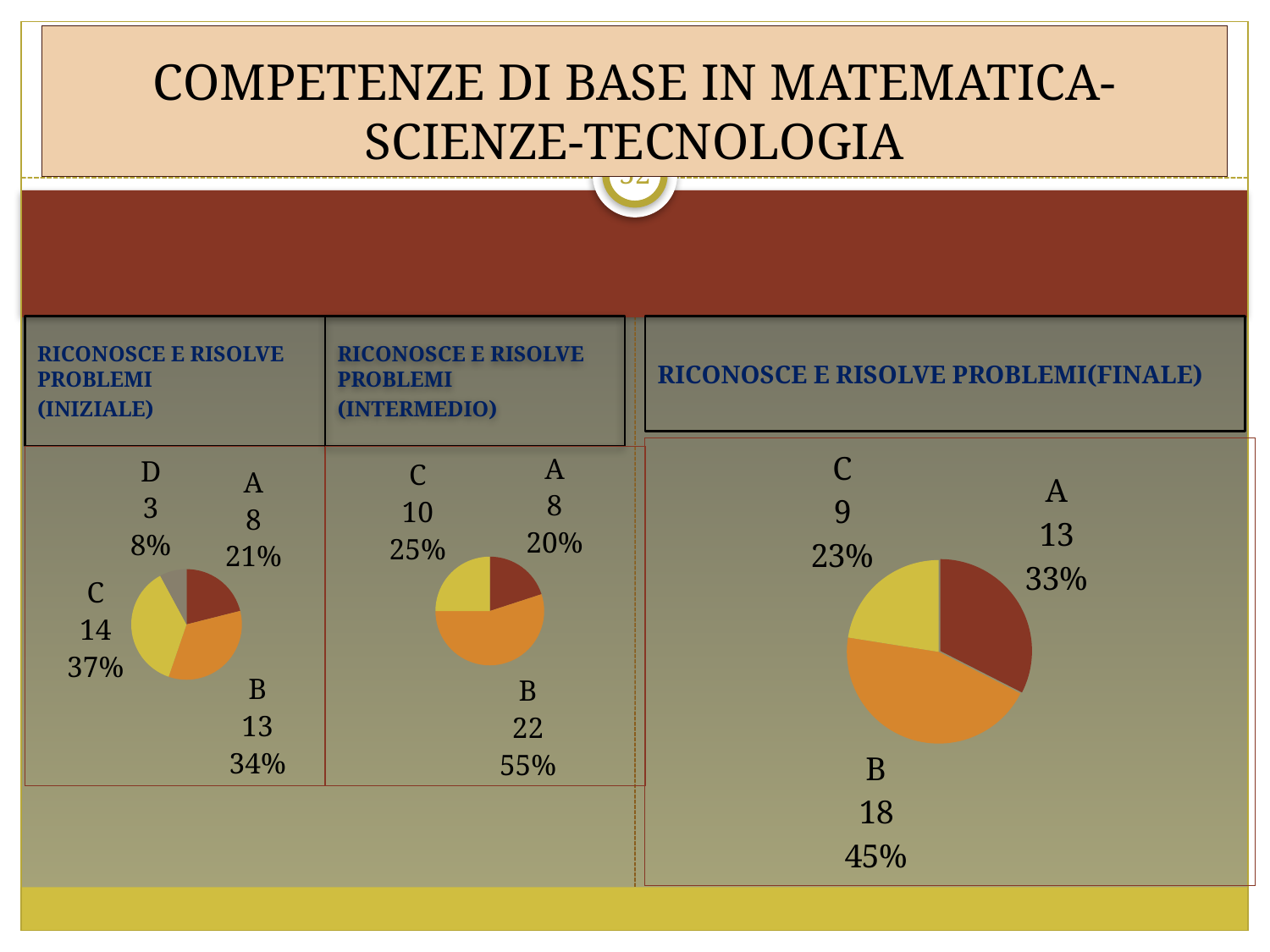
In the RICONOSCE E RISOLVE PROBLEMI (FINALE) chart, which is larger, the value for A or the value for C? A In the RICONOSCE E RISOLVE PROBLEMI (INIZIALE) chart, what percentage share does category D have? 8% What type of chart is used for RICONOSCE E RISOLVE PROBLEMI (FINALE)? Pie chart In the RICONOSCE E RISOLVE PROBLEMI (INTERMEDIO) chart, what is the difference between the values for B and C? 12 How many categories are shown in the RICONOSCE E RISOLVE PROBLEMI (FINALE) chart? 3 How many categories are shown in the RICONOSCE E RISOLVE PROBLEMI (INIZIALE) chart? 4 In the RICONOSCE E RISOLVE PROBLEMI (INIZIALE) chart, what is the value for category C? 14 In the RICONOSCE E RISOLVE PROBLEMI (FINALE) chart, what is the difference between the values for B and A? 5 In the RICONOSCE E RISOLVE PROBLEMI (INTERMEDIO) chart, which category has the highest value? B In the RICONOSCE E RISOLVE PROBLEMI (INTERMEDIO) chart, what is the value for category B? 22 In the RICONOSCE E RISOLVE PROBLEMI (INIZIALE) chart, which category has the lowest value? D In the RICONOSCE E RISOLVE PROBLEMI (FINALE) chart, what percentage share does category A have? 33%